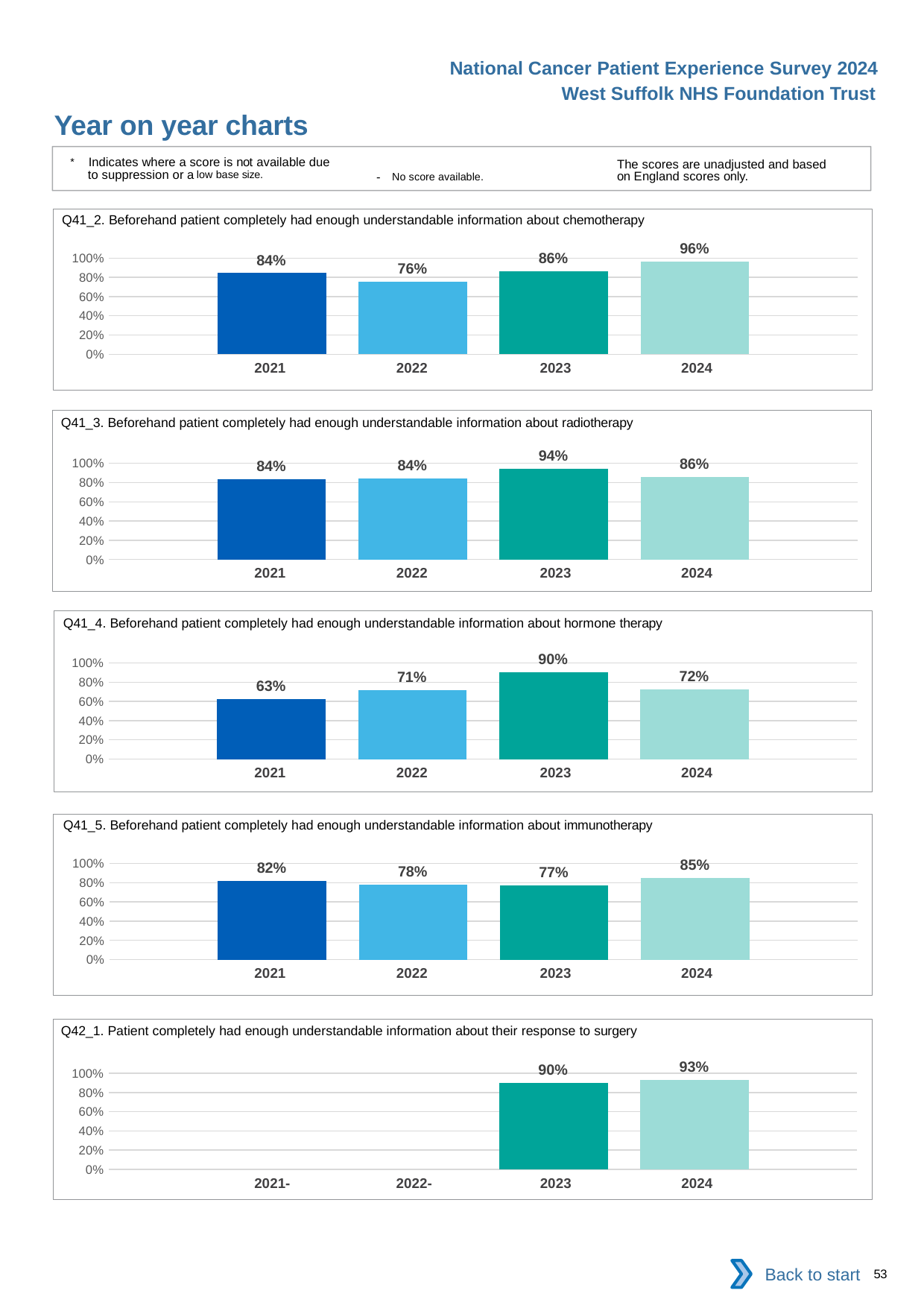
In the Q41_2 chemotherapy chart, which year has the lowest value? 2022 In the Q41_4 hormone therapy chart, which is larger, the value for 2022 or the value for 2024? 2024 In the Q42_1 response to surgery chart, how many years have a bar plotted? 2 In the Q41_3 radiotherapy chart, what is the difference between the 2023 and 2024 values? 8% In the Q41_3 radiotherapy chart, which year has the highest value? 2023 In the Q41_4 hormone therapy chart, what is the value for 2021? 63% In the Q41_5 immunotherapy chart, what is the value for 2023? 77% What kind of chart is the Q41_2 chemotherapy chart? Bar chart In the Q42_1 response to surgery chart, what is the value for 2024? 93% In the Q41_4 hormone therapy chart, is the value for 2021 greater or less than 80%? less In the Q41_5 immunotherapy chart, what is the difference between the 2024 and 2021 values? 3% In the Q41_2 chemotherapy chart, what is the value for 2024? 96%